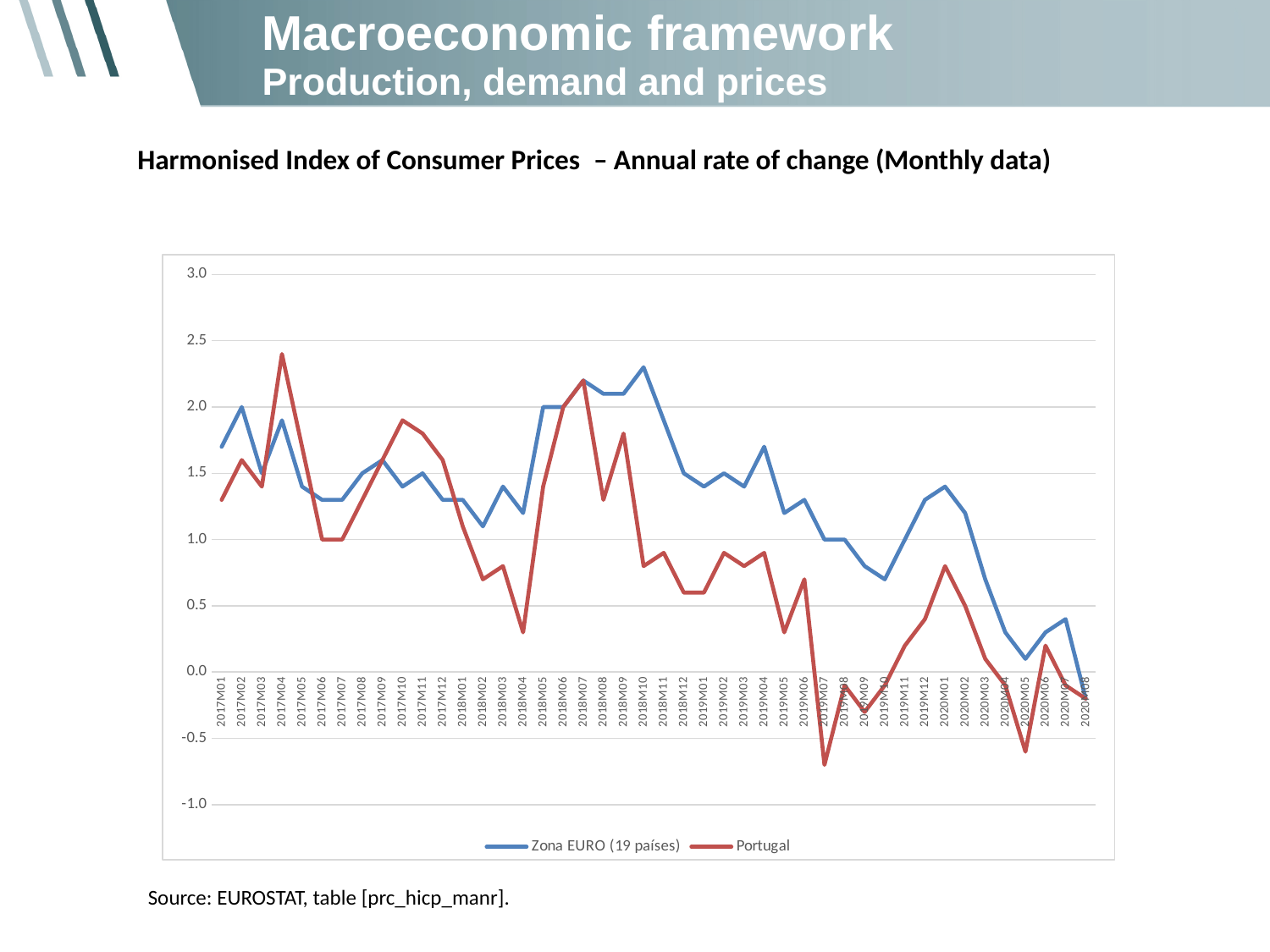
Which colour is used for the Portugal line? Red Is the value for Portugal in 2019M07 greater or less than -0.5? less What kind of chart is shown on the slide? Line chart Is the value for Zona EURO (19 países) in 2018M10 greater or less than 2.0? greater What are the two series named in the legend? Zona EURO (19 países) and Portugal How many series does the legend list? 2 In which month does the Portugal series reach its highest value? 2017M04 In 2018M10, which series has the higher value, Zona EURO (19 países) or Portugal? Zona EURO (19 países) Is the value for Portugal in 2018M04 greater or less than 0.5? less In 2017M04, which series has the higher value, Zona EURO (19 países) or Portugal? Portugal How many monthly data points are plotted along the x axis (from 2017M01 to 2020M08)? 44